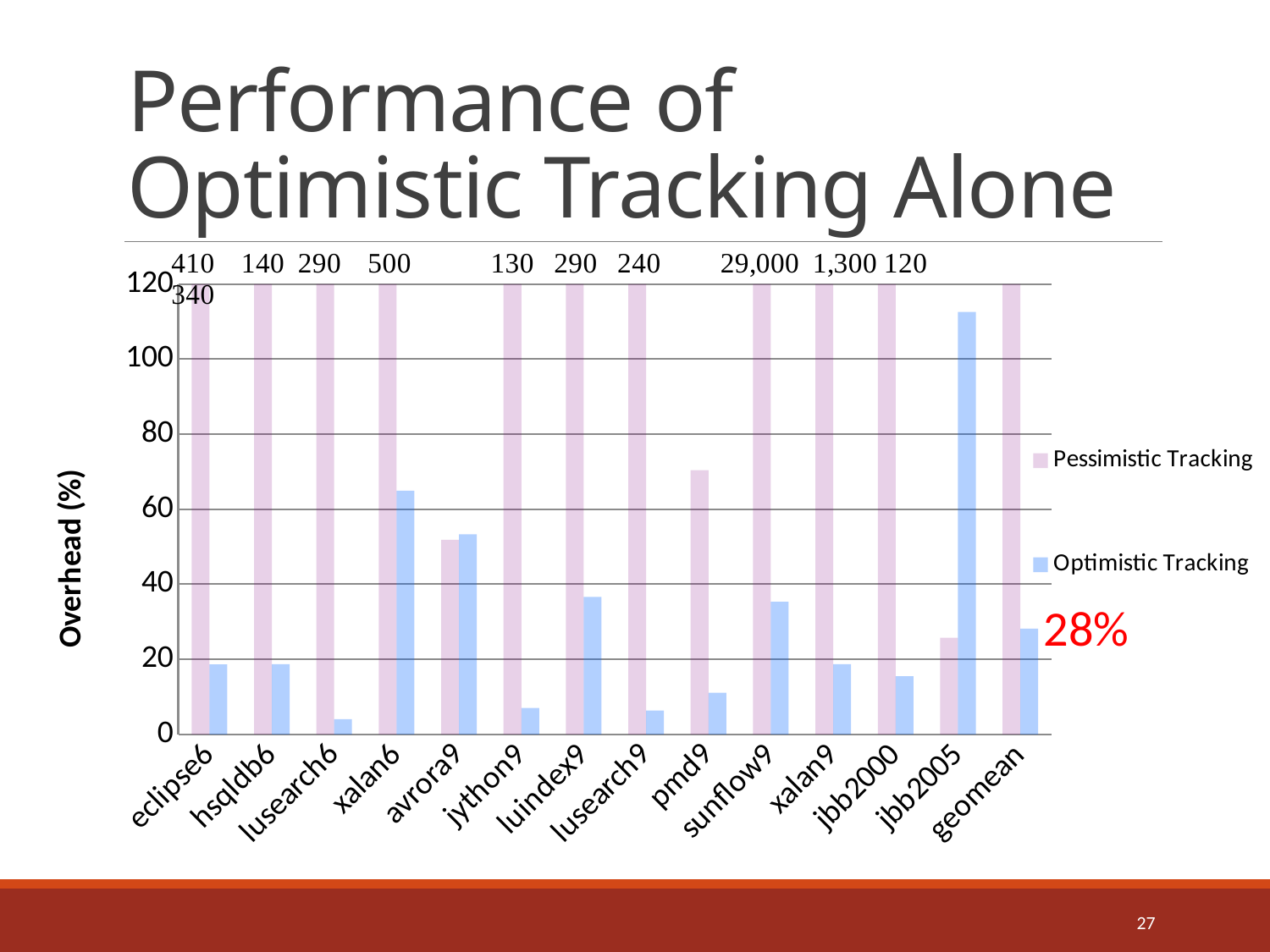
What is the Optimistic Tracking overhead for geomean? 28% What kind of chart is shown on the slide? bar chart How many benchmark categories are shown on the x axis? 14 What is the Pessimistic Tracking overhead value printed for xalan9? 1,300 Is the Optimistic Tracking value for jbb2005 greater or less than 100? greater What is the Pessimistic Tracking overhead value printed for sunflow9? 29,000 What is the label on the y axis? Overhead (%) How many series does the legend list? 2 What is the Pessimistic Tracking overhead value printed for xalan6? 500 Which benchmark has the highest Optimistic Tracking overhead? jbb2005 Is the Optimistic Tracking value for lusearch6 greater or less than 20? less Which is larger: the Optimistic Tracking value for xalan6 or for hsqldb6? xalan6